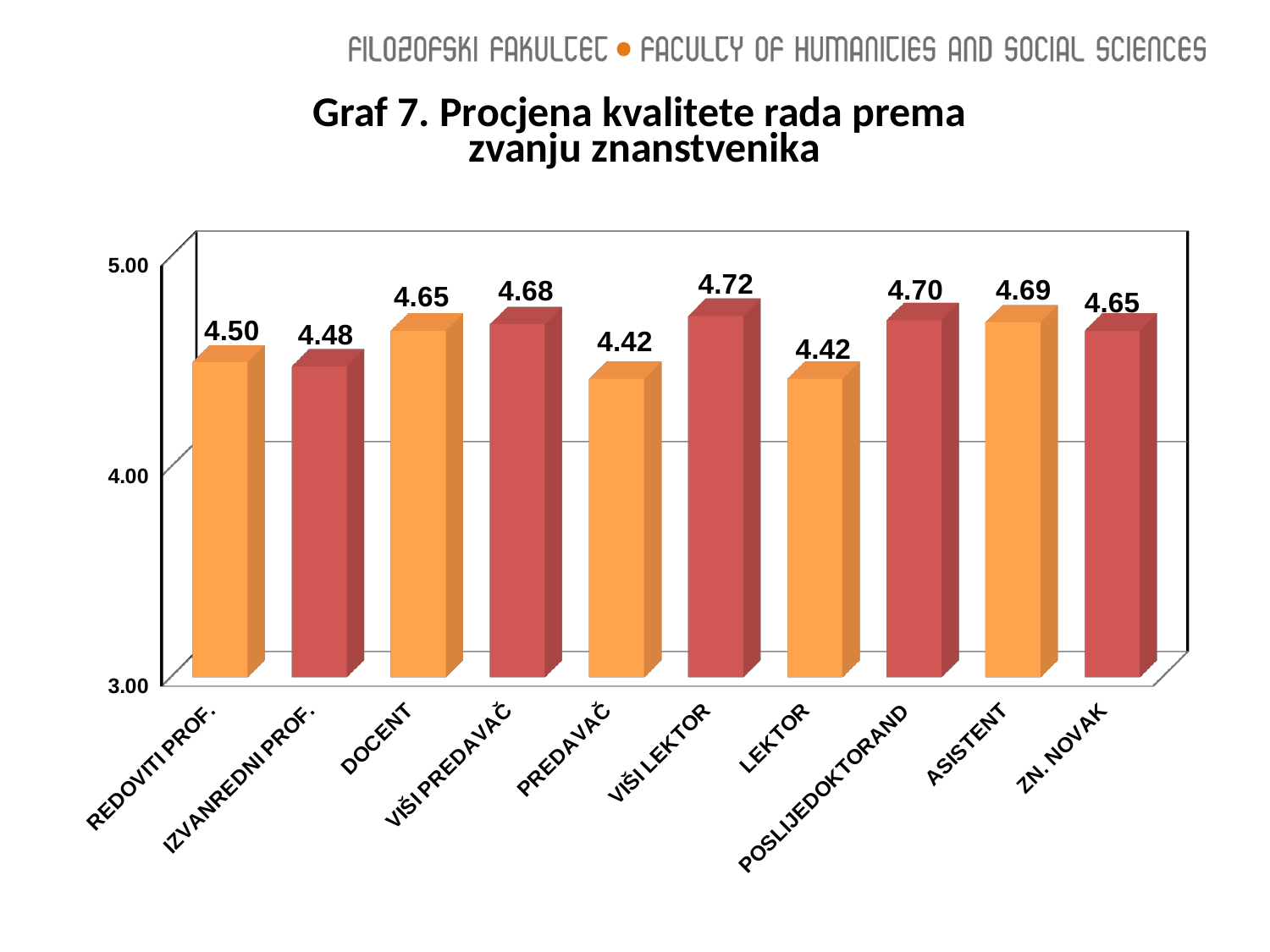
What is the title of the chart? Graf 7. Procjena kvalitete rada prema zvanju znanstvenika What is the difference between the values for VIŠI LEKTOR and LEKTOR? 0.30 Which is larger, the value for ASISTENT or the value for IZVANREDNI PROF.? ASISTENT What is the value for REDOVITI PROF.? 4.50 What kind of chart is shown on the slide? bar chart What is the value for POSLIJEDOKTORAND? 4.70 Which category has the highest value? VIŠI LEKTOR What is the lowest value shown on the vertical axis? 3.00 What is the value for VIŠI LEKTOR? 4.72 How many categories are shown on the chart? 10 What is the difference between the values for DOCENT and REDOVITI PROF.? 0.15 Is the value for PREDAVAČ greater or less than 4.00? greater